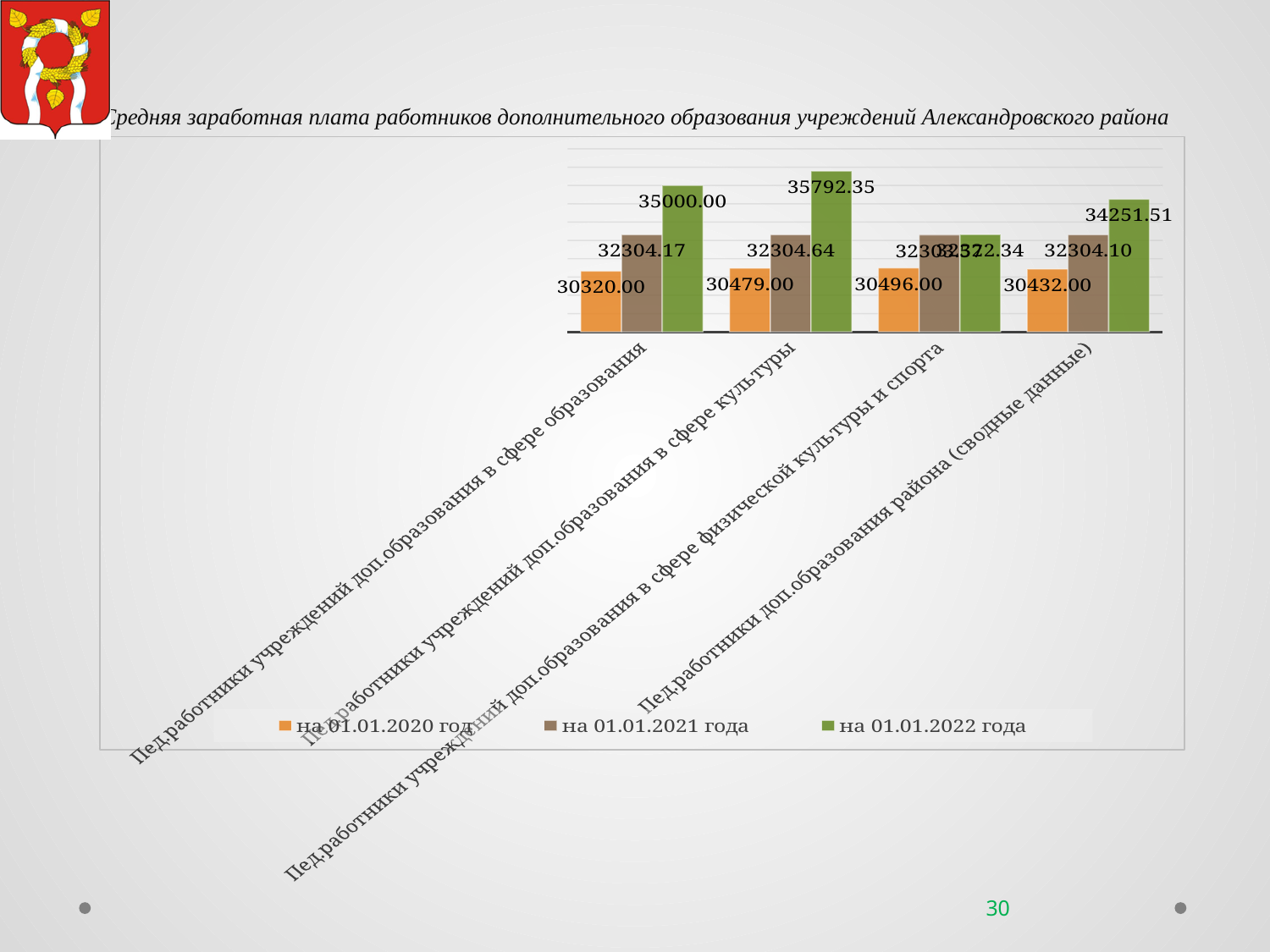
What are the three legend entries of the chart? на 01.01.2020 год, на 01.01.2021 года, на 01.01.2022 года What is the difference between the 'на 01.01.2022 года' and 'на 01.01.2020 года' values for 'Пед.работники учреждений доп.образования в сфере образования'? 4680.00 What is the value for 'Пед.работники доп.образования района (сводные данные)' for the series 'на 01.01.2021 года'? 32304.10 How many series does the legend list? 3 What is the value for 'Пед.работники учреждений доп.образования в сфере культуры' for the series 'на 01.01.2020 года'? 30479.00 What is the value for 'Пед.работники доп.образования района (сводные данные)' for the series 'на 01.01.2022 года'? 34251.51 Which category has the lowest value for the series 'на 01.01.2020 года'? Пед.работники учреждений доп.образования в сфере образования For the series 'на 01.01.2020 года', which is larger: the value for the sphere of culture or the value for the sphere of education? the sphere of culture How many categories are shown on the x axis? 4 Which category has the highest value for the series 'на 01.01.2022 года'? Пед.работники учреждений доп.образования в сфере культуры What is the value for 'Пед.работники учреждений доп.образования в сфере образования' for the series 'на 01.01.2022 года'? 35000.00 What kind of chart is shown on the slide? bar chart